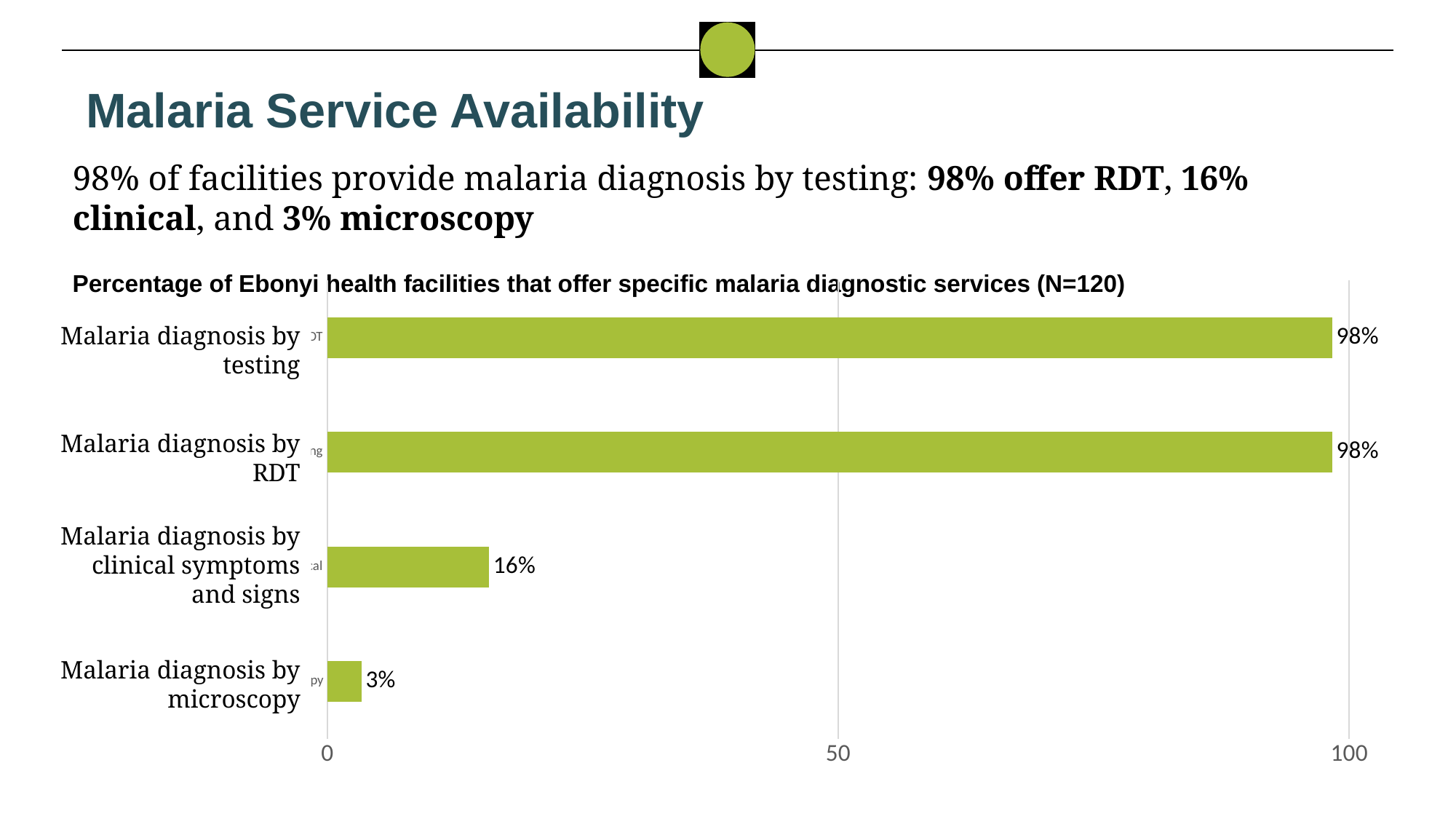
Which diagnostic service has the lowest percentage of facilities offering it? Malaria diagnosis by microscopy Which is larger: the percentage for malaria diagnosis by clinical symptoms and signs or for malaria diagnosis by microscopy? Malaria diagnosis by clinical symptoms and signs Is the value for malaria diagnosis by RDT greater or less than 50? greater What percentage of facilities offer malaria diagnosis by microscopy? 3% What percentage of facilities offer malaria diagnosis by RDT? 98% How many diagnostic service categories are shown in the chart? 4 What type of chart is shown on the slide? Bar chart What percentage of facilities offer malaria diagnosis by testing? 98% What percentage of facilities offer malaria diagnosis by clinical symptoms and signs? 16% What is the difference in percentage points between malaria diagnosis by RDT and malaria diagnosis by clinical symptoms and signs? 82 What is the difference in percentage points between malaria diagnosis by clinical symptoms and signs and malaria diagnosis by microscopy? 13 What is the sample size (N) stated in the chart title? 120